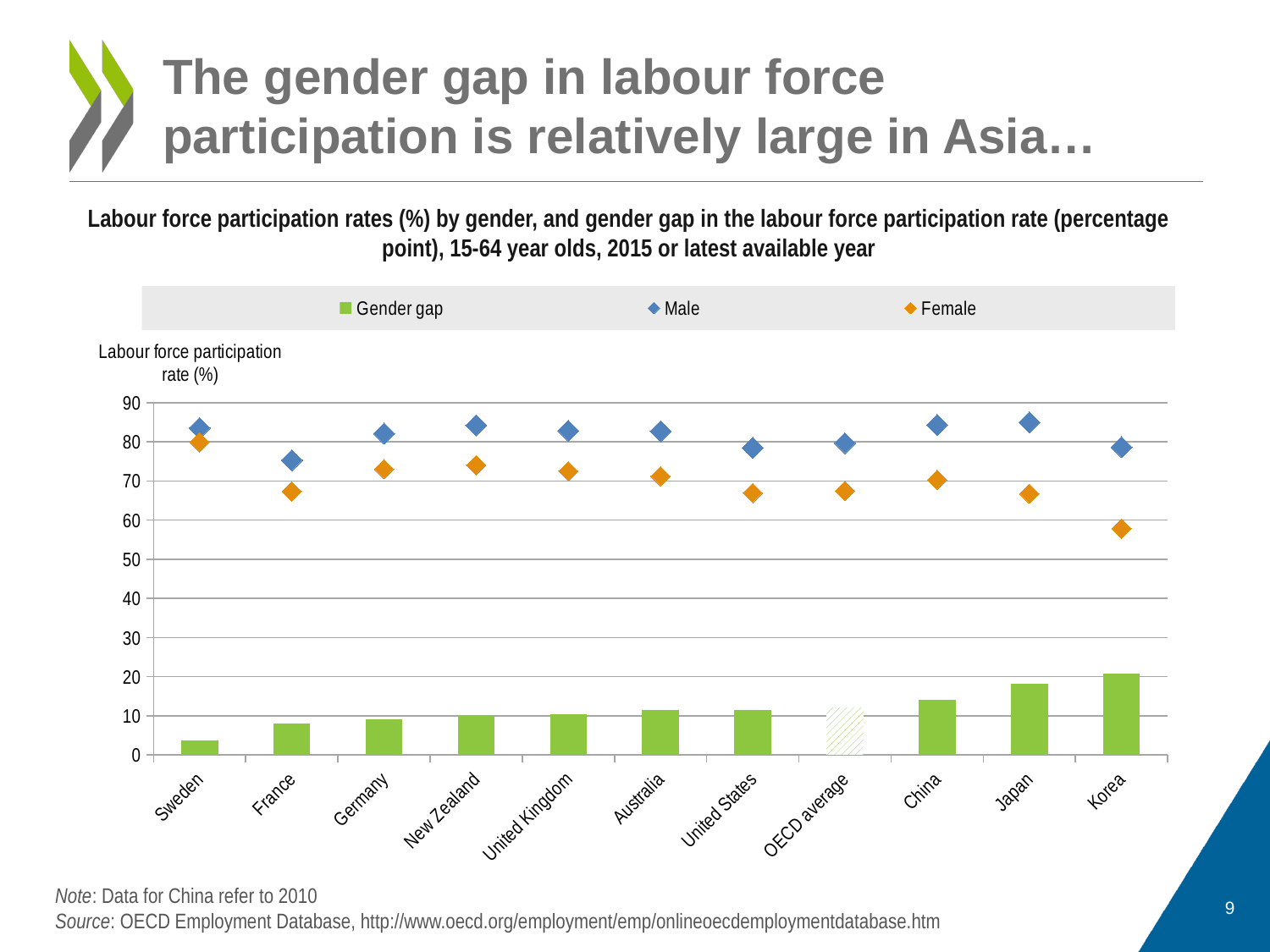
Is the Male value for France greater or less than 70? greater How many countries or categories are shown on the x axis of the chart? 11 How many series does the chart's legend list? 3 Is the Gender gap value for Sweden greater or less than 10? less Is the Gender gap value for Korea greater or less than 10? greater Which category has the lowest Gender gap bar? Sweden Which category has the highest Gender gap bar? Korea Which category has the highest Female labour force participation rate? Sweden Which category has the lowest Female labour force participation rate? Korea Which series in the legend is plotted as bars? Gender gap Which has the larger Gender gap, Japan or Korea? Korea